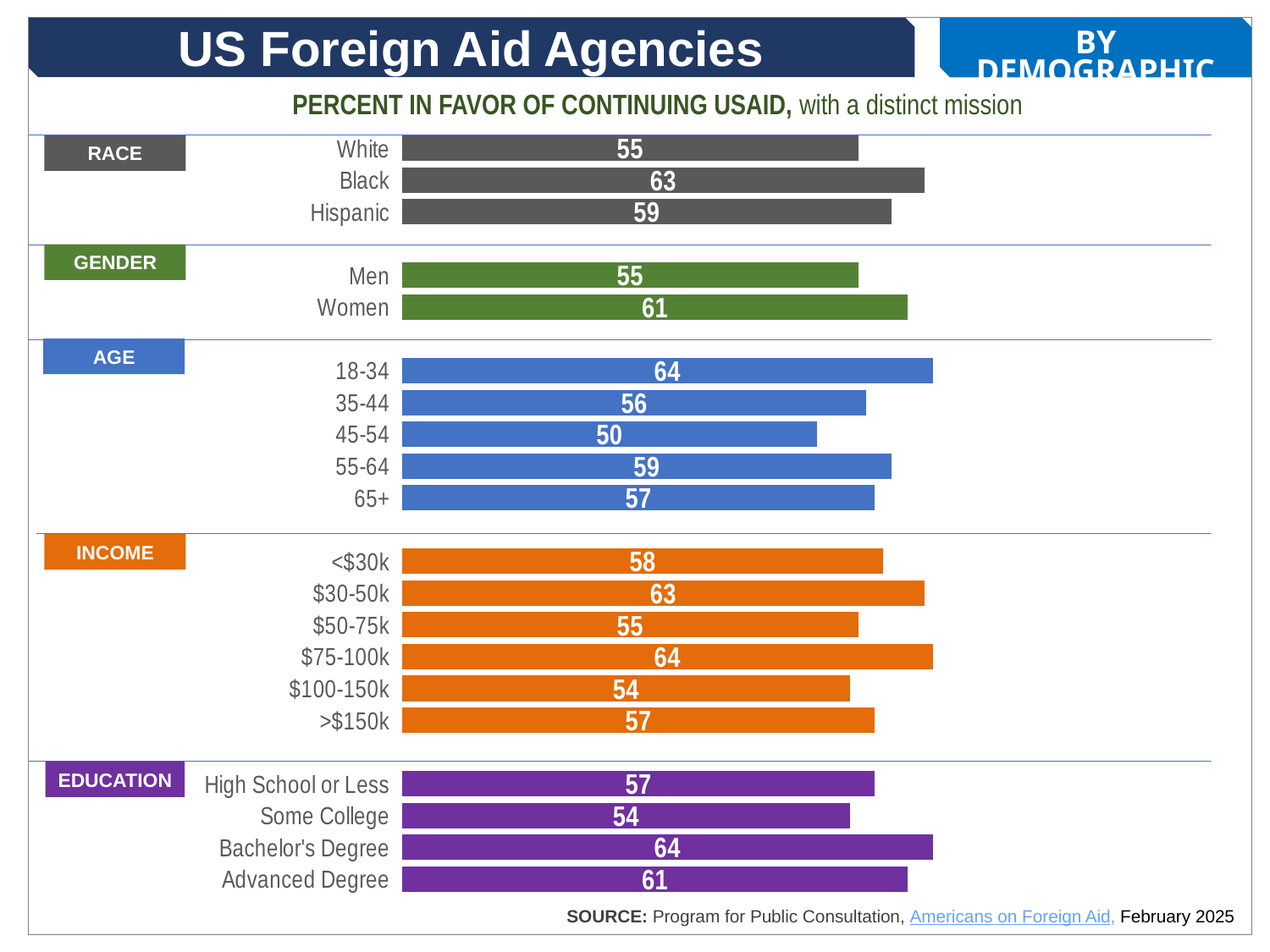
Which age group has the highest percent in favor? 18-34 Which education level has the highest percent in favor? Bachelor's Degree What is the value for the 45-54 age group? 50 Which income group has the lowest percent in favor? $100-150k What is the value for the $75-100k income group? 64 How many age groups are shown in the chart? 5 Which is larger, the value for Black or the value for Hispanic? Black What percent of Black respondents favor continuing USAID? 63 Which age group has the lowest percent in favor? 45-54 What is the difference between the values for Women and Men? 6 What type of chart is shown on the slide? Bar chart What is the value shown for Women? 61